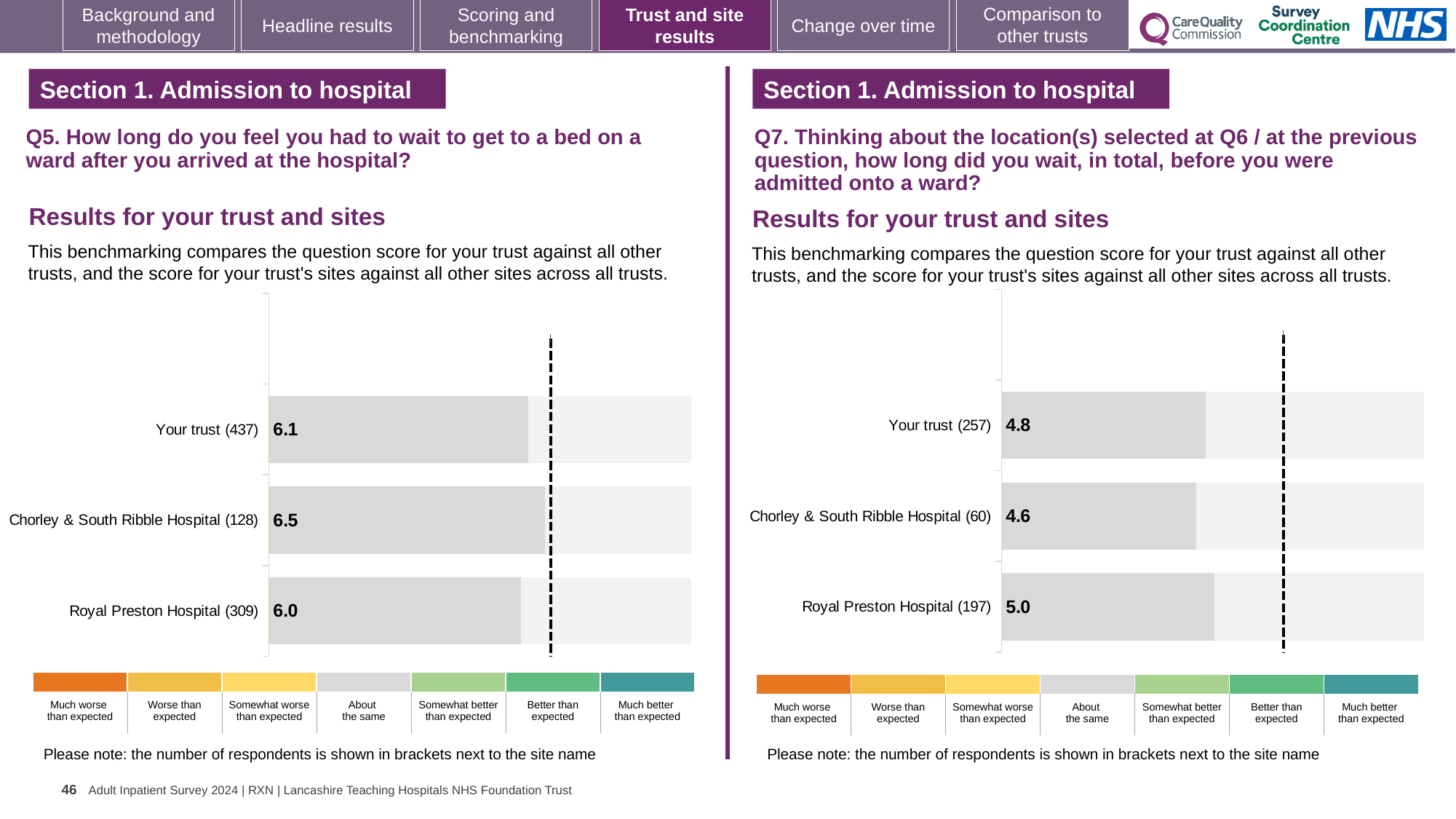
How many bars are plotted on the left chart (Q5)? 3 On the right chart (Q7), what is the difference between the scores for Royal Preston Hospital and Chorley & South Ribble Hospital? 0.4 On the left chart (Q5), what is the score for Your trust (437)? 6.1 What type of chart is used on the right side of the slide (Q7)? Bar chart On the left chart (Q5), which site or trust has the highest score? Chorley & South Ribble Hospital (128) On the left chart (Q5), what is the score for Chorley & South Ribble Hospital (128)? 6.5 On the left chart (Q5), what is the difference between the scores for Chorley & South Ribble Hospital and Royal Preston Hospital? 0.5 On the right chart (Q7), what is the score for Royal Preston Hospital (197)? 5.0 On the right chart (Q7), which site or trust has the lowest score? Chorley & South Ribble Hospital (60) On the left chart (Q5), which site or trust has the lowest score? Royal Preston Hospital (309) On the right chart (Q7), which is larger, the score for Your trust or the score for Royal Preston Hospital? Royal Preston Hospital On the right chart (Q7), what is the score for Your trust (257)? 4.8